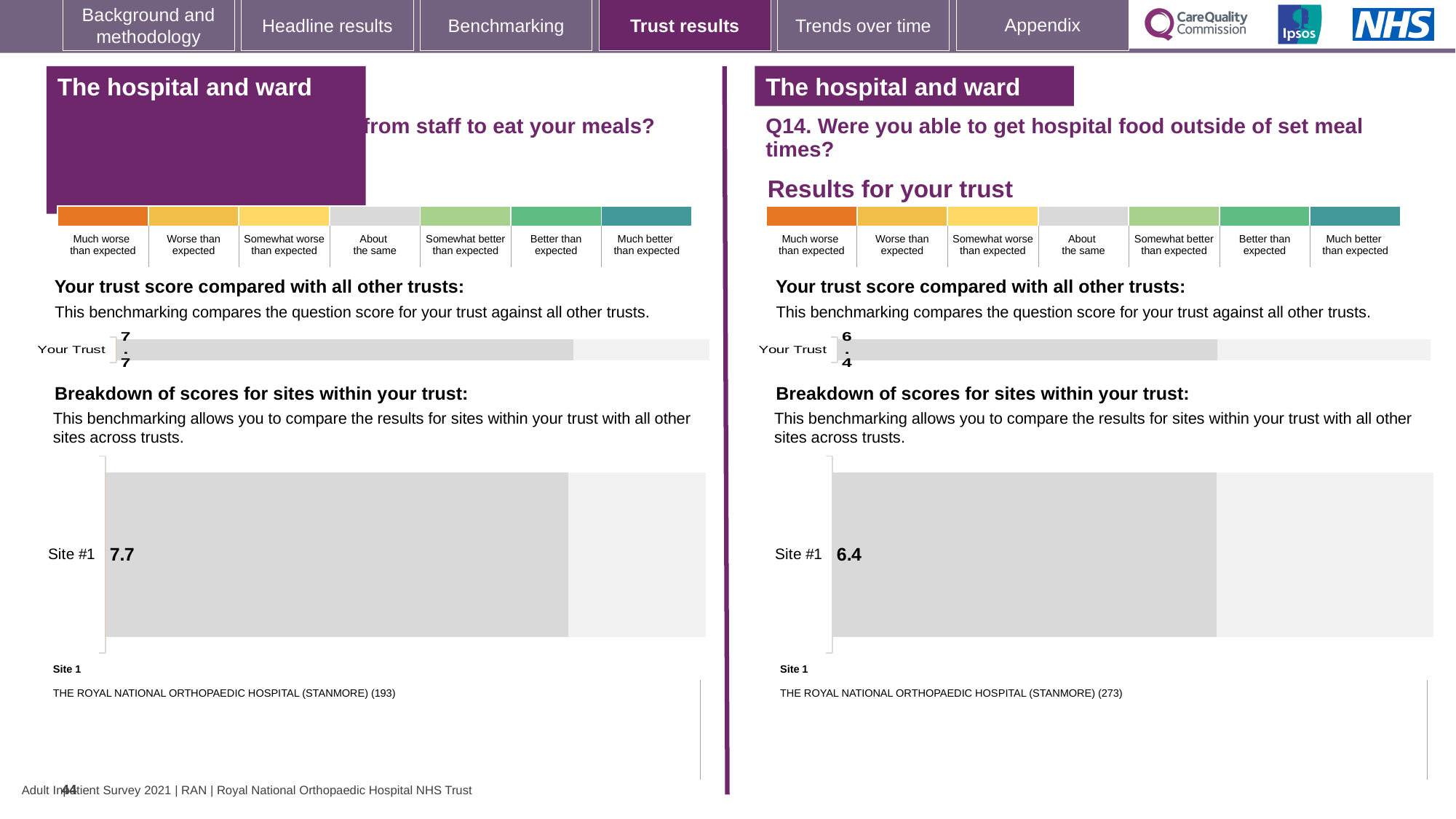
On the left panel, what score is shown for Site #1 in the breakdown of scores for sites chart? 7.7 What is the difference between the Site #1 score on the left panel and the Site #1 score on the right panel (Q14)? 1.3 What is the difference between the Your Trust score on the left panel and the Your Trust score on the right panel (Q14)? 1.3 On the right panel (Q14), which hospital is listed as Site 1? THE ROYAL NATIONAL ORTHOPAEDIC HOSPITAL (STANMORE) How many sites are shown in the breakdown of scores for sites chart on the right panel (Q14)? 1 On the right panel (Q14), what score is shown for Site #1 in the breakdown of scores for sites chart? 6.4 What type of chart is used to show the breakdown of scores for sites on the right panel (Q14)? Bar chart On the left panel, what is the score shown for Your Trust? 7.7 On the left panel, what number appears in brackets after the Site 1 hospital name? 193 Which panel shows the higher Site #1 score, the left panel or the right panel (Q14)? Left panel On the right panel (Q14), what is the score shown for Your Trust? 6.4